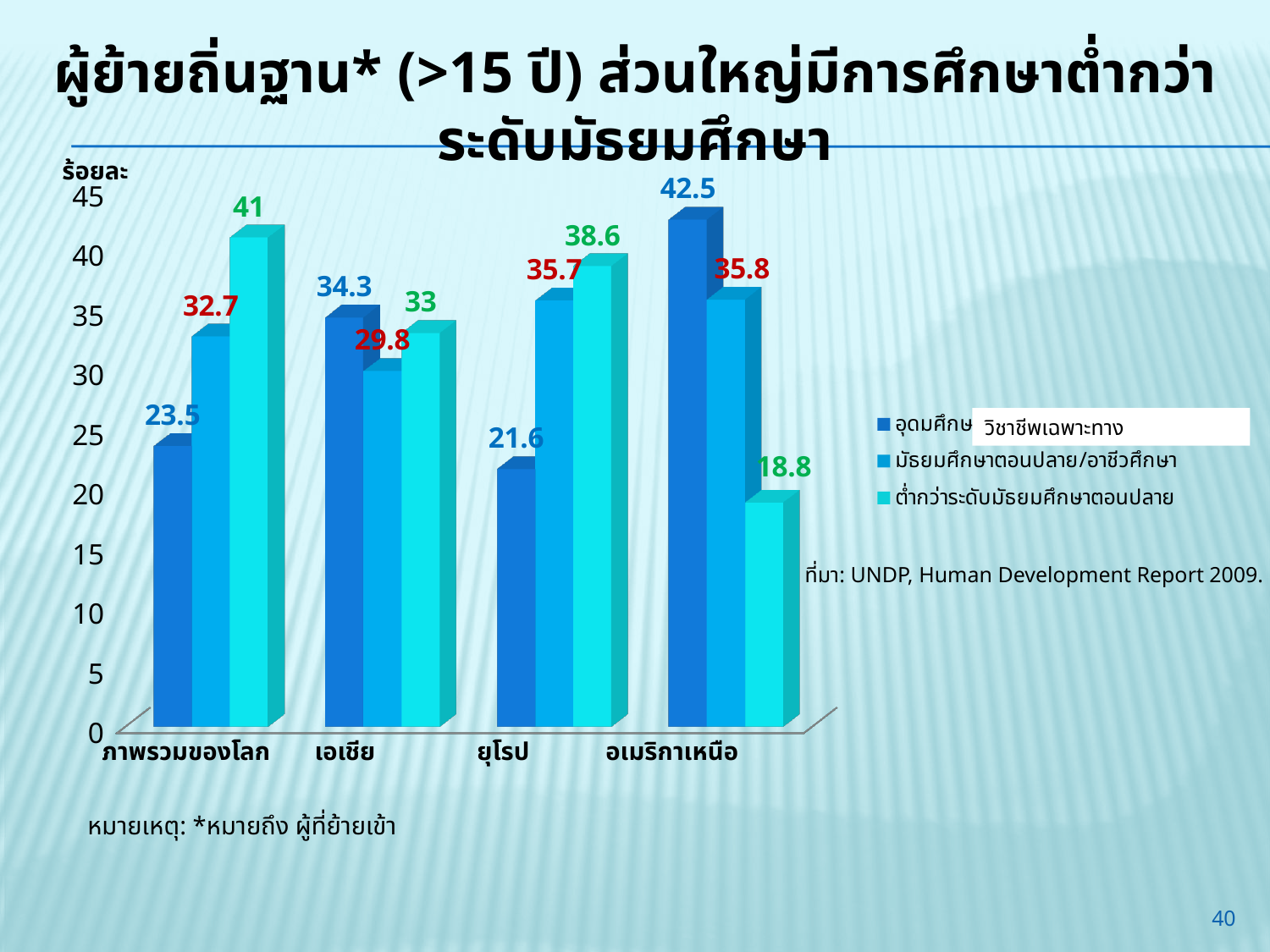
What type of chart is shown on the slide? bar chart What is the value of ต่ำกว่าระดับมัธยมศึกษาตอนปลาย for อเมริกาเหนือ? 18.8 How many series does the chart's legend list? 3 What is the value of ต่ำกว่าระดับมัธยมศึกษาตอนปลาย for ภาพรวมของโลก? 41 What is the value of the dark blue (first) series for ยุโรป? 21.6 What is the unit label shown above the y axis of the chart? ร้อยละ What is the difference between the ต่ำกว่าระดับมัธยมศึกษาตอนปลาย value for ภาพรวมของโลก and for อเมริกาเหนือ? 22.2 Which region has the highest value for the dark blue (first) series? อเมริกาเหนือ Which region has the lowest value for ต่ำกว่าระดับมัธยมศึกษาตอนปลาย? อเมริกาเหนือ How many categories (regions) are shown on the x axis of the chart? 4 What is the value of มัธยมศึกษาตอนปลาย/อาชีวศึกษา for เอเชีย? 29.8 For ยุโรป, which is larger: มัธยมศึกษาตอนปลาย/อาชีวศึกษา or ต่ำกว่าระดับมัธยมศึกษาตอนปลาย? ต่ำกว่าระดับมัธยมศึกษาตอนปลาย